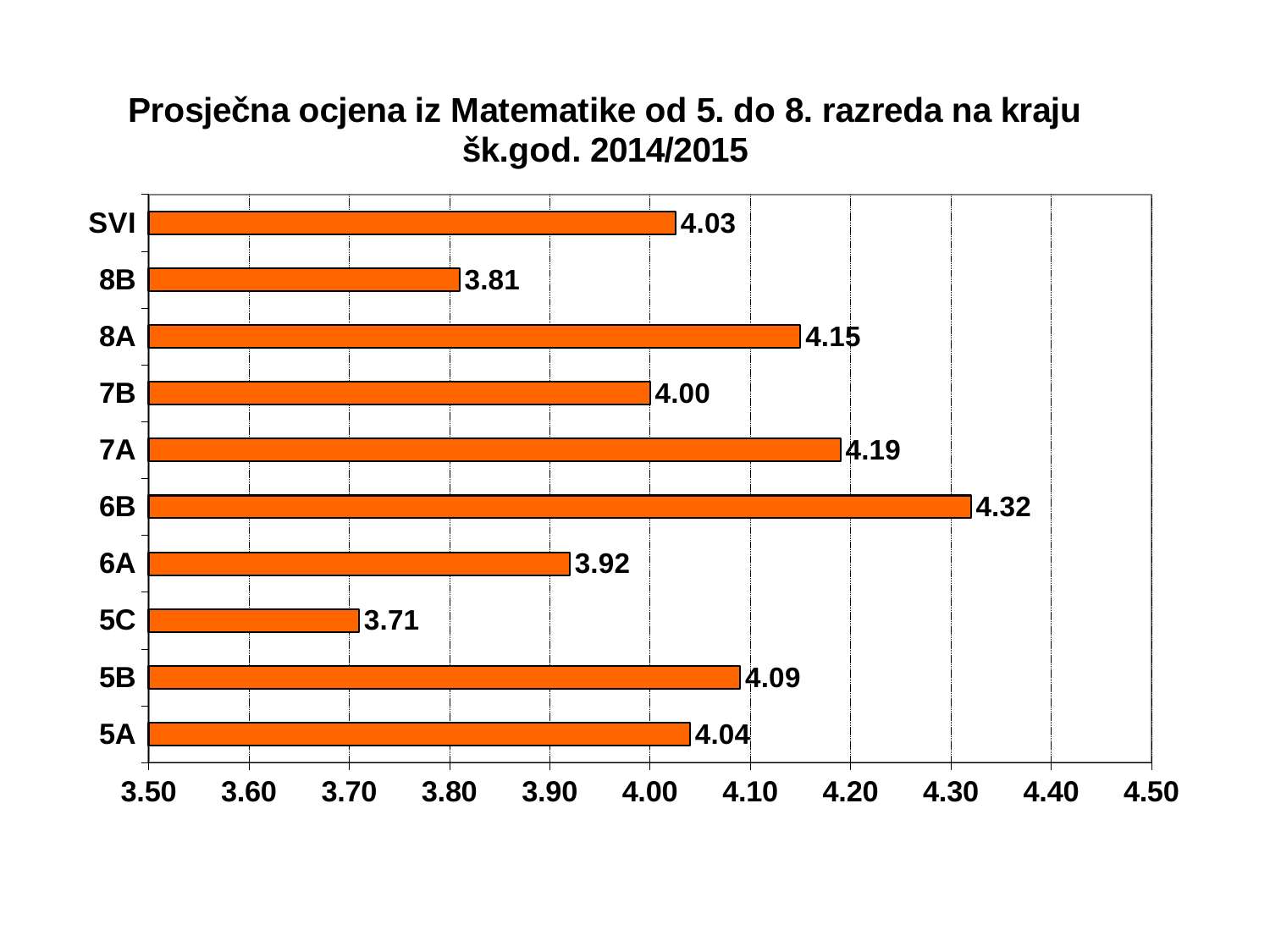
What is the average grade for class 5C? 3.71 What is the title of the chart? Prosječna ocjena iz Matematike od 5. do 8. razreda na kraju šk.god. 2014/2015 What is the average Mathematics grade for class 6B? 4.32 Which class has the lowest average Mathematics grade? 5C What is the difference between the average grades of 6B and 6A? 0.40 How many bars are shown in the chart? 10 Is the value for 5B greater or less than 4.00? greater What kind of chart is shown on the slide? bar chart Which class has the highest average Mathematics grade? 6B What is the difference between the values for 8A and 8B? 0.34 Which has a higher average grade, 7A or 7B? 7A What is the value shown for SVI? 4.03